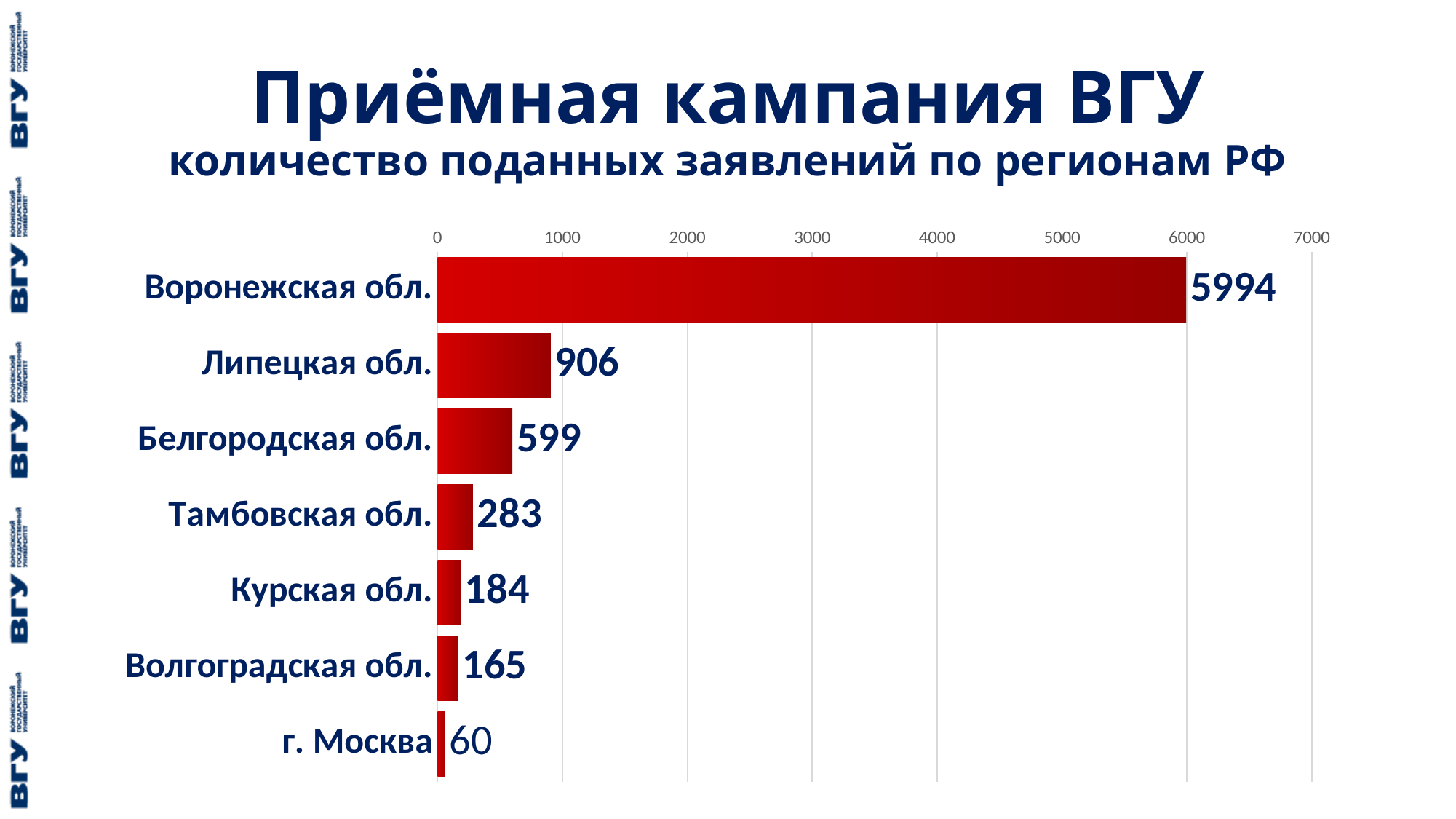
What is the value shown for Тамбовская обл.? 283 What is the value shown for г. Москва? 60 How many regions are shown in the chart? 7 What is the subtitle of the chart on the slide? количество поданных заявлений по регионам РФ Which region has the highest number of applications? Воронежская обл. What type of chart is shown on the slide? Bar chart What is the difference between the values for Курская обл. and Волгоградская обл.? 19 What is the difference between the values for Липецкая обл. and Белгородская обл.? 307 Which region has the lowest number of applications? г. Москва Which has a larger value, Белгородская обл. or Тамбовская обл.? Белгородская обл. What is the value shown for Липецкая обл.? 906 What is the number of applications for Воронежская обл.? 5994